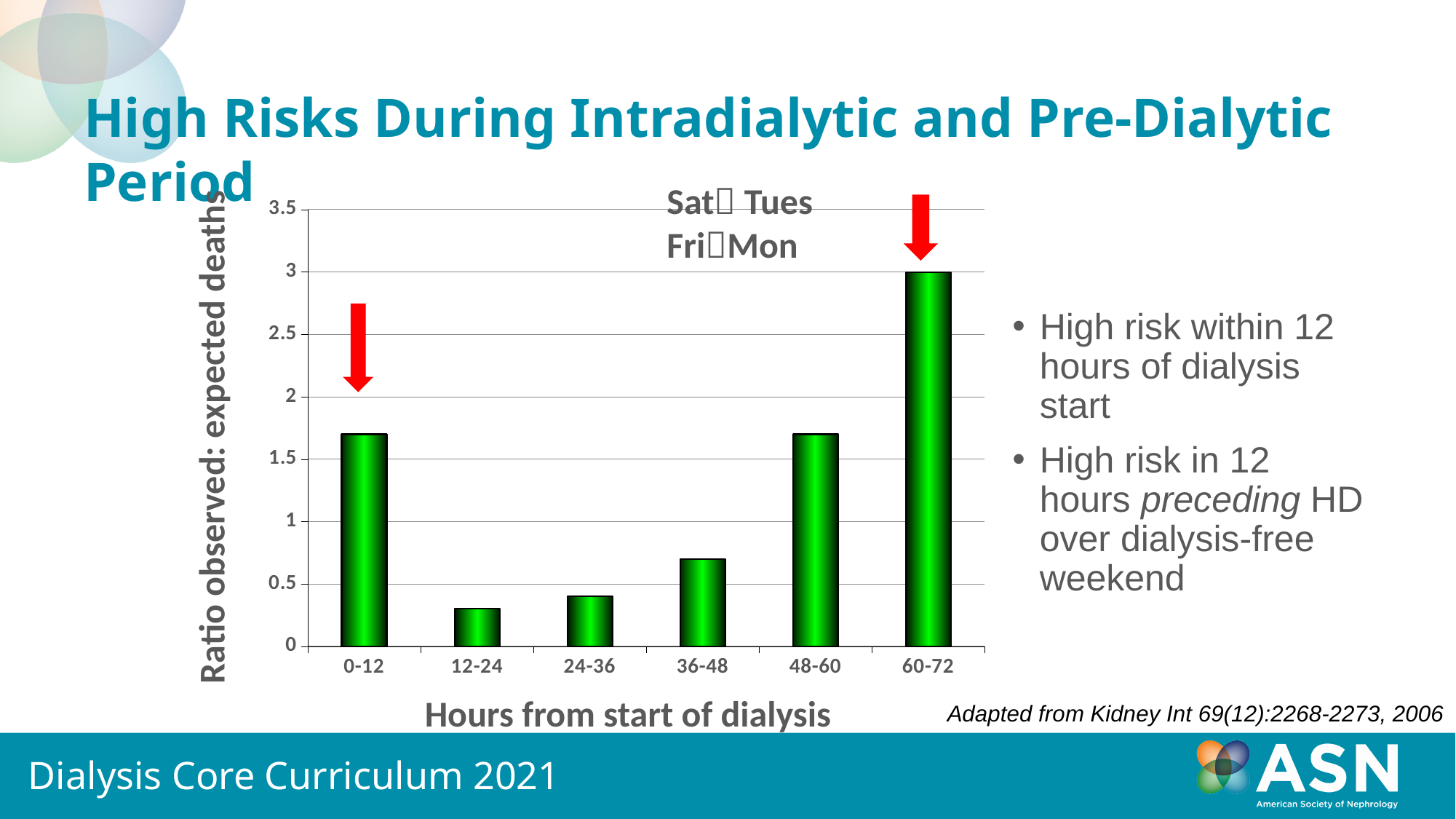
What is the title of the x axis? Hours from start of dialysis Which has the larger ratio, the 24-36 interval or the 36-48 interval? 36-48 What kind of chart is shown on the slide? bar chart What is the ratio of observed to expected deaths for the 60-72 hour interval? 3 Is the value for the 48-60 hour interval greater or less than 2? less Is the value for the 0-12 hour interval greater or less than 1.5? greater Which has the larger ratio, the 0-12 interval or the 60-72 interval? 60-72 Is the value for the 12-24 hour interval greater or less than 0.5? less What is the title of the y axis? Ratio observed: expected deaths Which hour interval has the highest ratio of observed to expected deaths? 60-72 How many hour-interval categories are shown on the x axis? 6